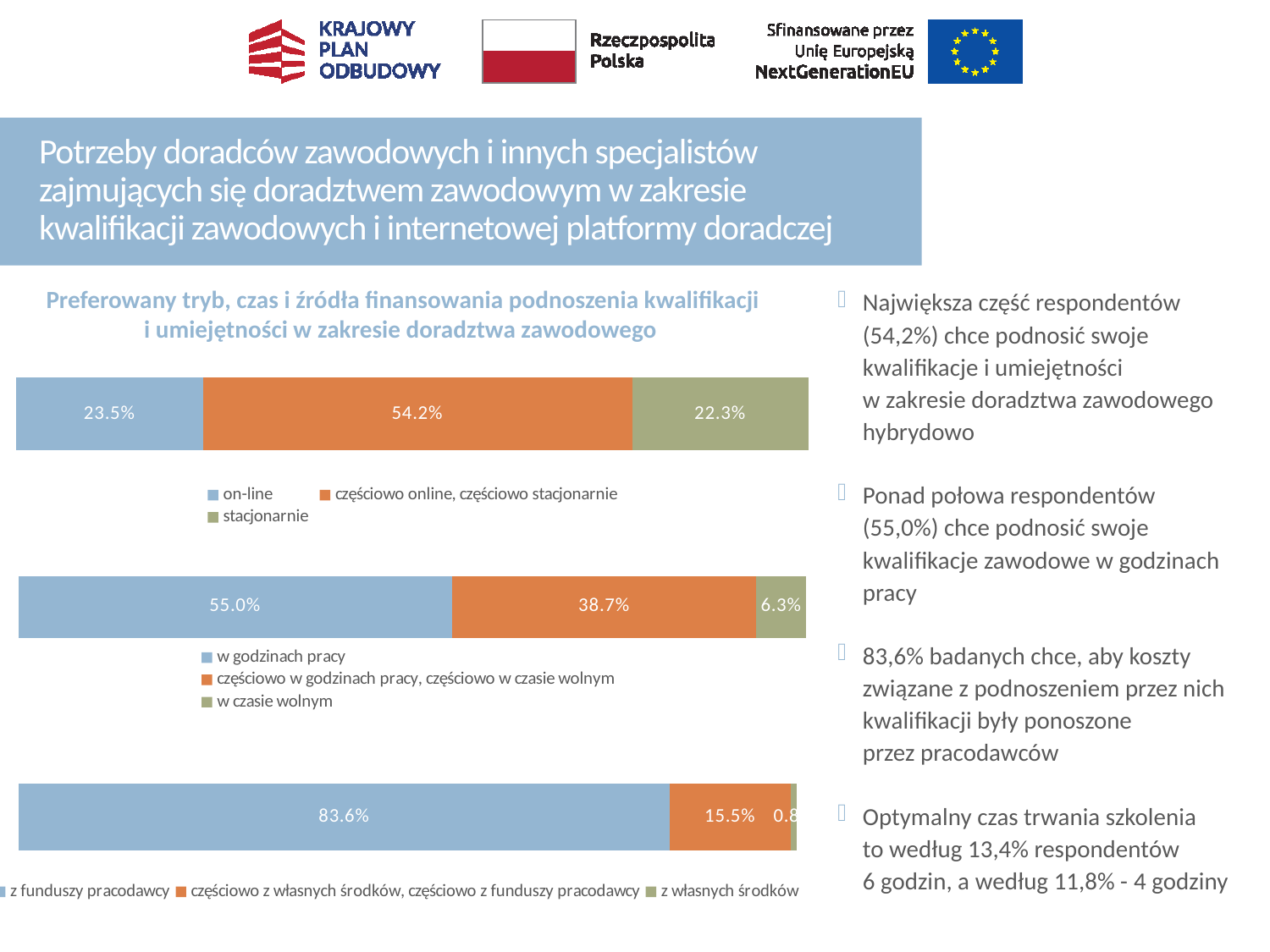
In the top chart, what percentage of respondents prefer the 'częściowo online, częściowo stacjonarnie' mode? 54.2% In the bottom chart, what is the value for 'częściowo z własnych środków, częściowo z funduszy pracodawcy'? 15.5% In the middle chart, what is the value for 'w godzinach pracy'? 55.0% In the top chart, what is the value for 'stacjonarnie'? 22.3% In the middle chart, what is the value for 'w czasie wolnym'? 6.3% In the top chart, what is the value for 'on-line'? 23.5% How many series does the legend of the middle chart list? 3 In the top chart, which category has the highest share? częściowo online, częściowo stacjonarnie In the middle chart, what is the difference between 'w godzinach pracy' and 'częściowo w godzinach pracy, częściowo w czasie wolnym'? 16.3% What type of chart is the top chart? Stacked bar chart In the middle chart, which category has the lowest share? w czasie wolnym In the bottom chart, what is the value for 'z funduszy pracodawcy'? 83.6%